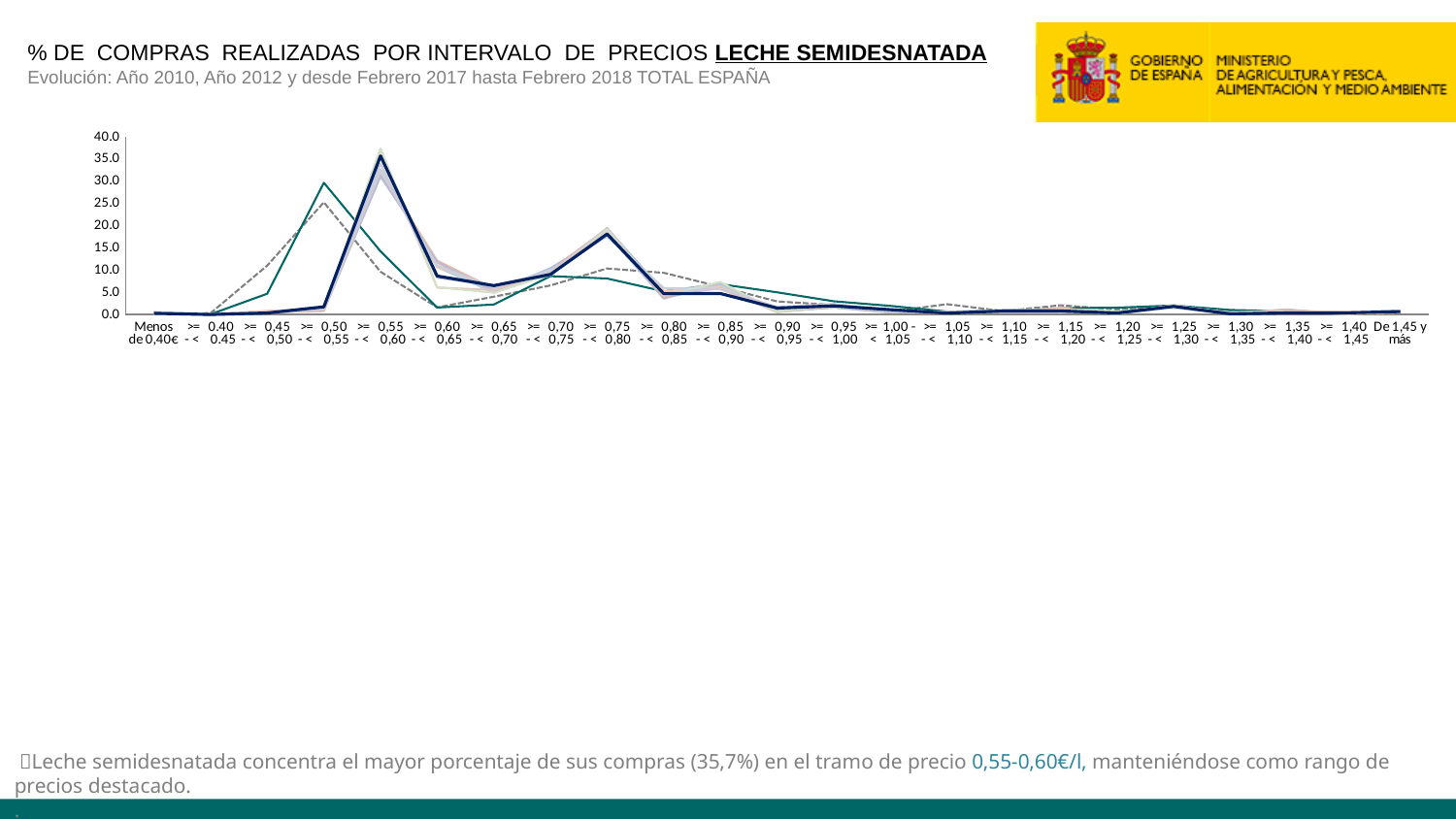
In which price interval does the dark navy line reach its highest value? >= 0,55 - < 0,60 How many price intervals are shown along the x axis of the chart? 23 Is the value of the green line in the >= 0,50 - < 0,55 interval greater or less than 25? greater Is the value of the dark navy line in the >= 0,75 - < 0,80 interval greater or less than 15? greater What is the highest value shown on the y axis of the chart? 40.0 Is the value of the dark navy line in the >= 0,75 - < 0,80 interval greater or less than 20? less Do the values of the lines generally rise or fall as the price intervals increase beyond >= 0,75 - < 0,80? Fall For the dark navy line, which interval has the larger value: >= 0,55 - < 0,60 or >= 0,75 - < 0,80? >= 0,55 - < 0,60 Which product is named in the chart title? LECHE SEMIDESNATADA What kind of chart is shown on the slide? Line chart